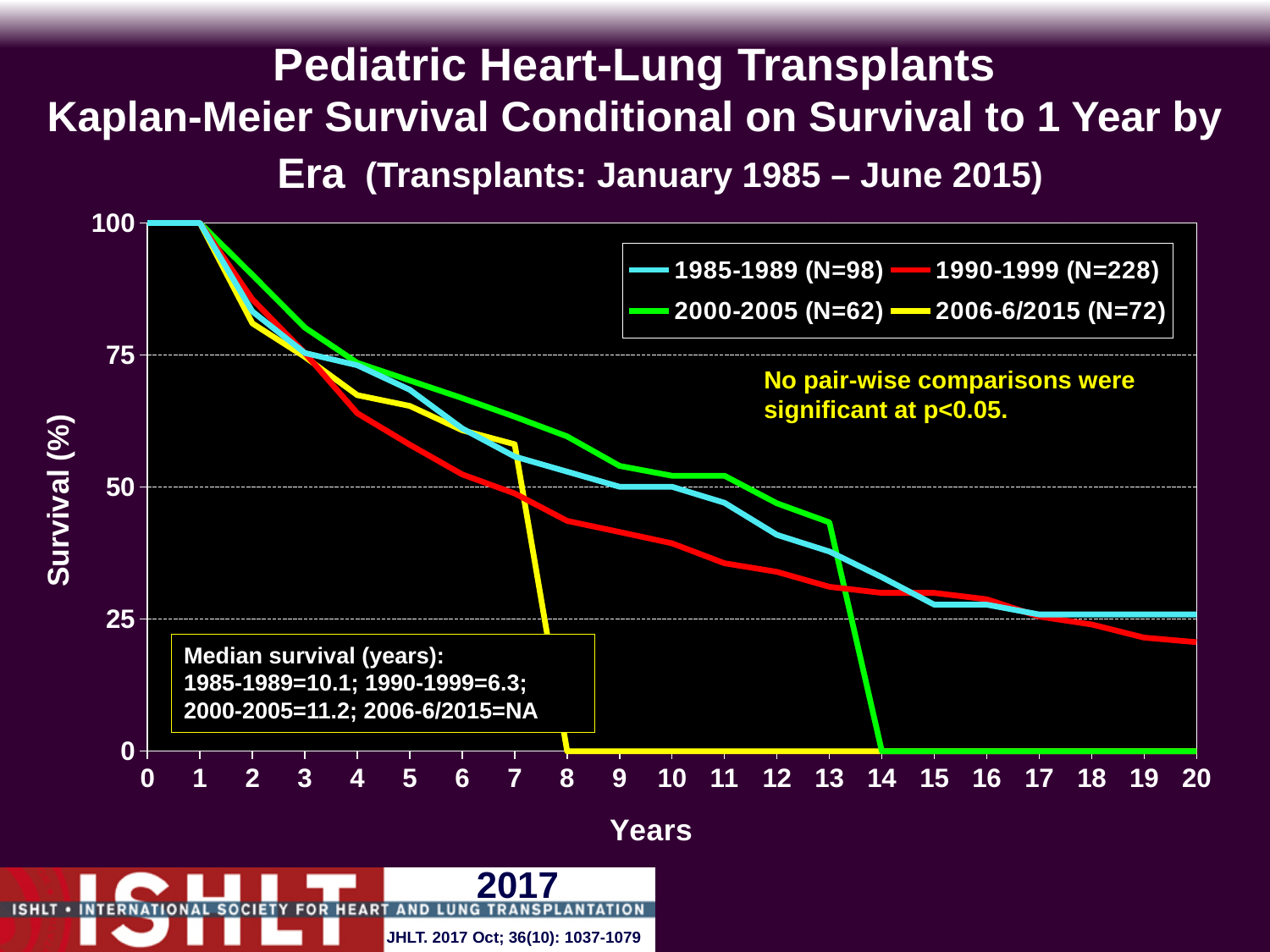
Is the survival value for the 2000-2005 era at year 8 greater or less than 50? greater What is the survival value for all eras at year 1? 100 What is the N for the 1990-1999 era shown in the legend? 228 According to the text box, what is the median survival in years for the 1990-1999 era? 6.3 What is the difference in median survival (years) between the 2000-2005 era and the 1990-1999 era? 4.9 Is the survival value for the 1990-1999 era at year 20 greater or less than 25? less Which era has the highest median survival listed in the text box? 2000-2005 What kind of chart is shown on the slide? line chart According to the text box, what is the median survival for the 2006-6/2015 era? NA How many series does the legend list? 4 Do the survival curves rise or fall as years increase along the x axis? fall According to the text box, what is the median survival in years for the 1985-1989 era? 10.1